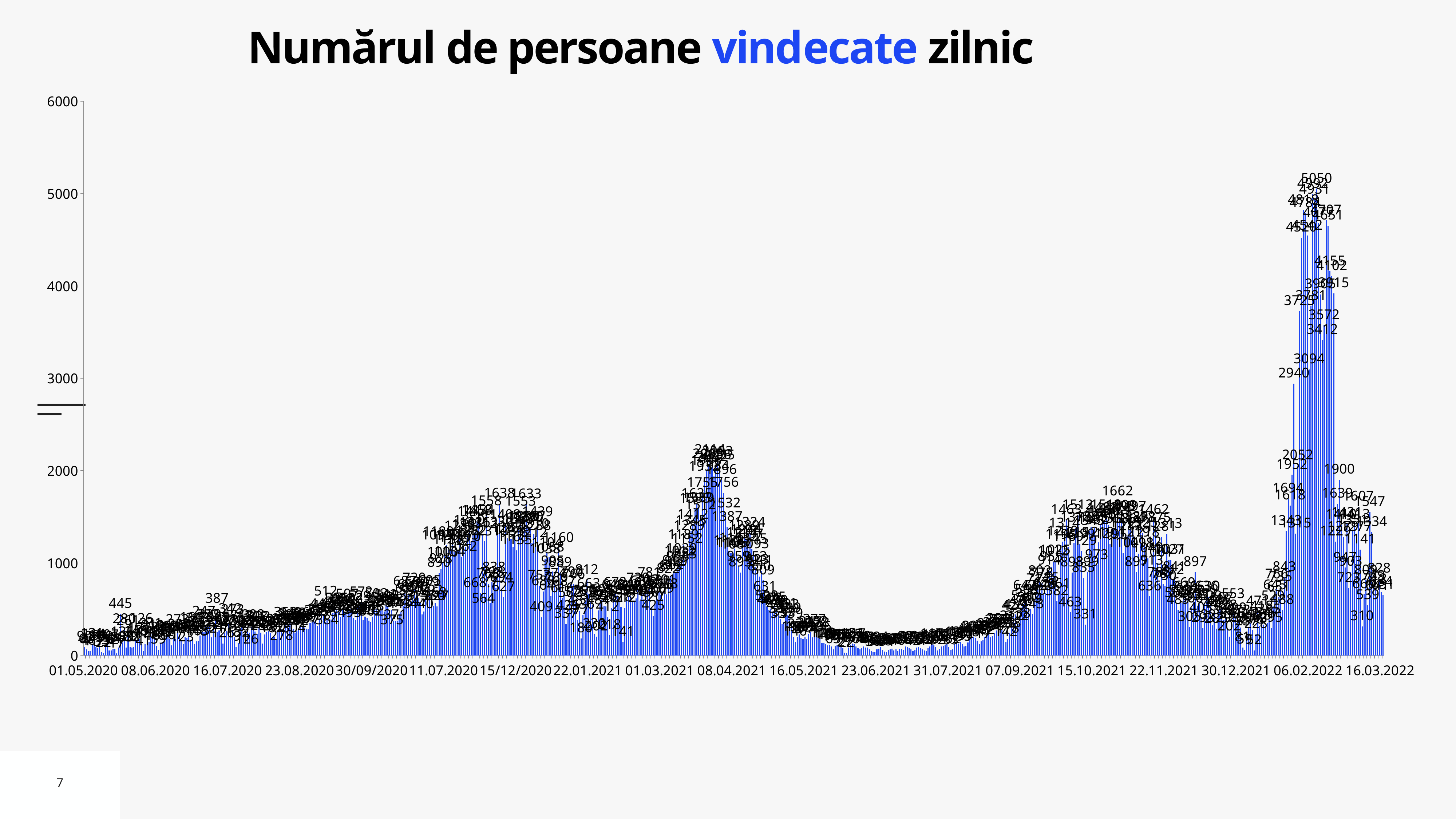
Which is larger: the peak of bars around 08.04.2021 or the peak of bars around 15.10.2021? the peak around 08.04.2021 What kind of chart is shown on the slide? bar chart What is the highest tick value shown on the y axis? 6000 Is the value of the bars around 23.06.2021 greater or less than 500? less Is the value of the highest bar around 08.04.2021 greater or less than 2000? greater Do the values rise or fall between 31.07.2021 and 15.10.2021? rise Do the values rise or fall between 16.05.2021 and 23.06.2021? fall What is the highest data label shown on the chart? 5050 Is the value of the tallest bar on the chart greater or less than 5000? greater What is the first date label on the x axis? 01.05.2020 Which is larger: the peak of bars around 06.02.2022 or the peak of bars around 08.04.2021? the peak around 06.02.2022 What is the title of the chart? Numărul de persoane vindecate zilnic